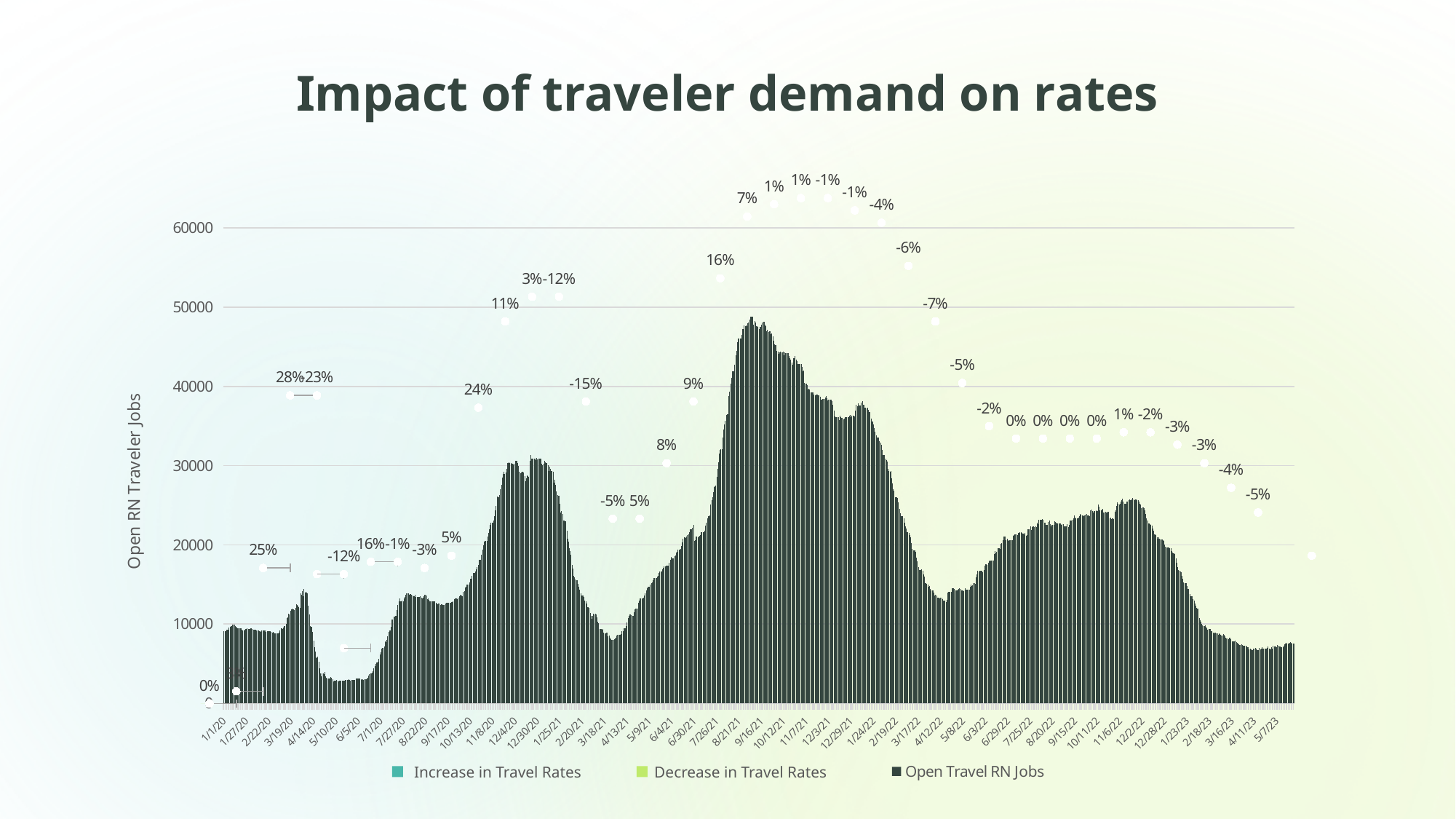
Which is larger, the 24% rate change label or the 11% rate change label? 24% What is the highest value shown on the vertical axis? 60000 How many series does the legend list? 3 What kind of chart is used to plot the Open Travel RN Jobs series? bar chart Is the number of Open Travel RN Jobs around 6/5/20 greater or less than 10000? less What is the highest travel rate change percentage labelled on the chart? 28% What is the lowest travel rate change percentage labelled on the chart? -15% What is the title of the chart? Impact of traveler demand on rates Do Open Travel RN Jobs rise or fall between 12/28/22 and 5/7/23? fall Is the peak number of Open Travel RN Jobs (around 8/21/21) greater or less than 40000? greater Is the number of Open Travel RN Jobs at the last date shown (5/7/23) greater or less than 10000? less What is the label on the vertical axis? Open RN Traveler Jobs